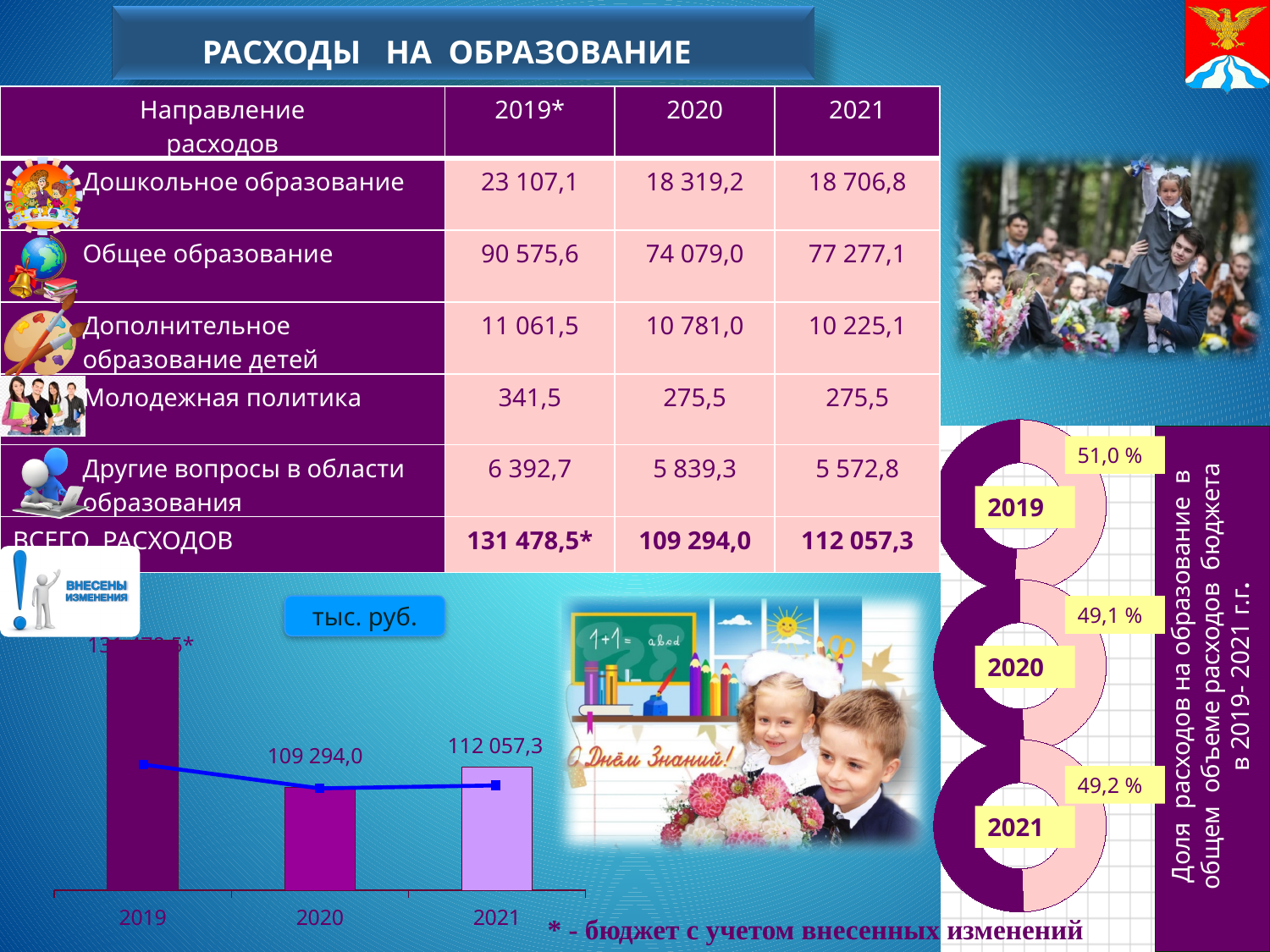
In the donut charts on the right, which year has the highest share? 2019 In the bar chart at the bottom left, which year has the tallest bar? 2019 In the bar chart at the bottom left, which year has the shortest bar? 2020 In the donut charts on the right, what share is shown for 2019? 51,0 % How many bars are in the bar chart at the bottom left? 3 In the bar chart at the bottom left, what is the value for 2020? 109 294,0 In the bar chart at the bottom left, what is the difference between the 2021 and 2020 values? 2 763,3 In the bar chart at the bottom left, what is the value for 2021? 112 057,3 In the donut charts on the right, what share is shown for 2020? 49,1 % In the bar chart at the bottom left, what unit is shown in the label above the chart? тыс. руб. What kind of chart is shown at the bottom left of the slide? bar chart In the bar chart at the bottom left, which is larger, the value for 2020 or for 2021? 2021